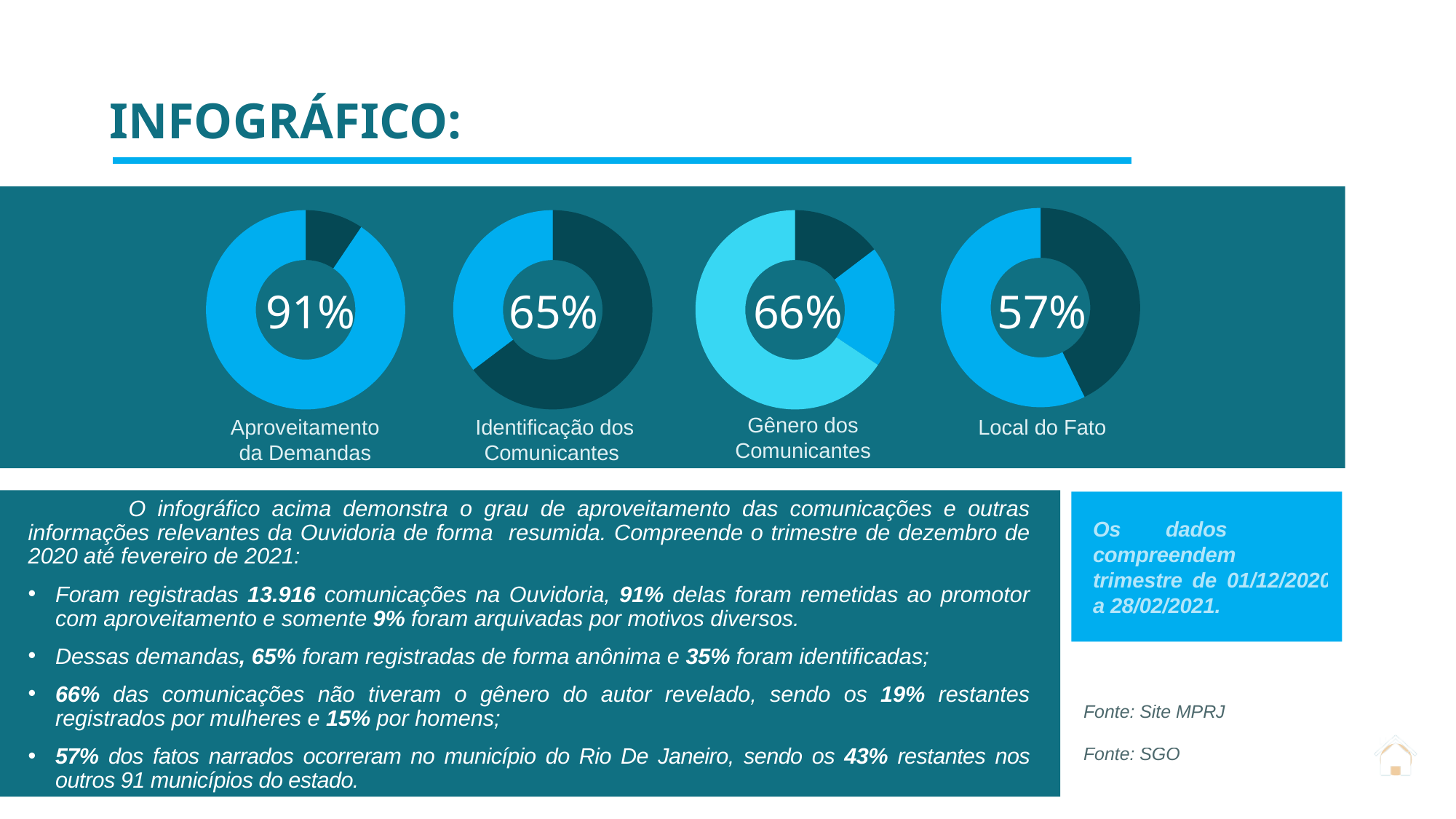
What value is shown in the centre of the "Gênero dos Comunicantes" donut chart? 66% Which of the four donut charts shows the lowest centre value? Local do Fato What type of chart is used for "Aproveitamento da Demandas"? Donut (pie) chart What is the title of the slide containing the four donut charts? INFOGRÁFICO: How many donut charts are shown on the slide? 4 What value is shown in the centre of the "Identificação dos Comunicantes" donut chart? 65% What value is shown in the centre of the "Aproveitamento da Demandas" donut chart? 91% How many slices does the "Gênero dos Comunicantes" donut chart have? 3 Which chart shows a larger centre value: "Identificação dos Comunicantes" or "Local do Fato"? Identificação dos Comunicantes What is the difference between the centre values of the "Aproveitamento da Demandas" chart and the "Local do Fato" chart? 34% Which of the four donut charts shows the highest centre value? Aproveitamento da Demandas What value is shown in the centre of the "Local do Fato" donut chart? 57%